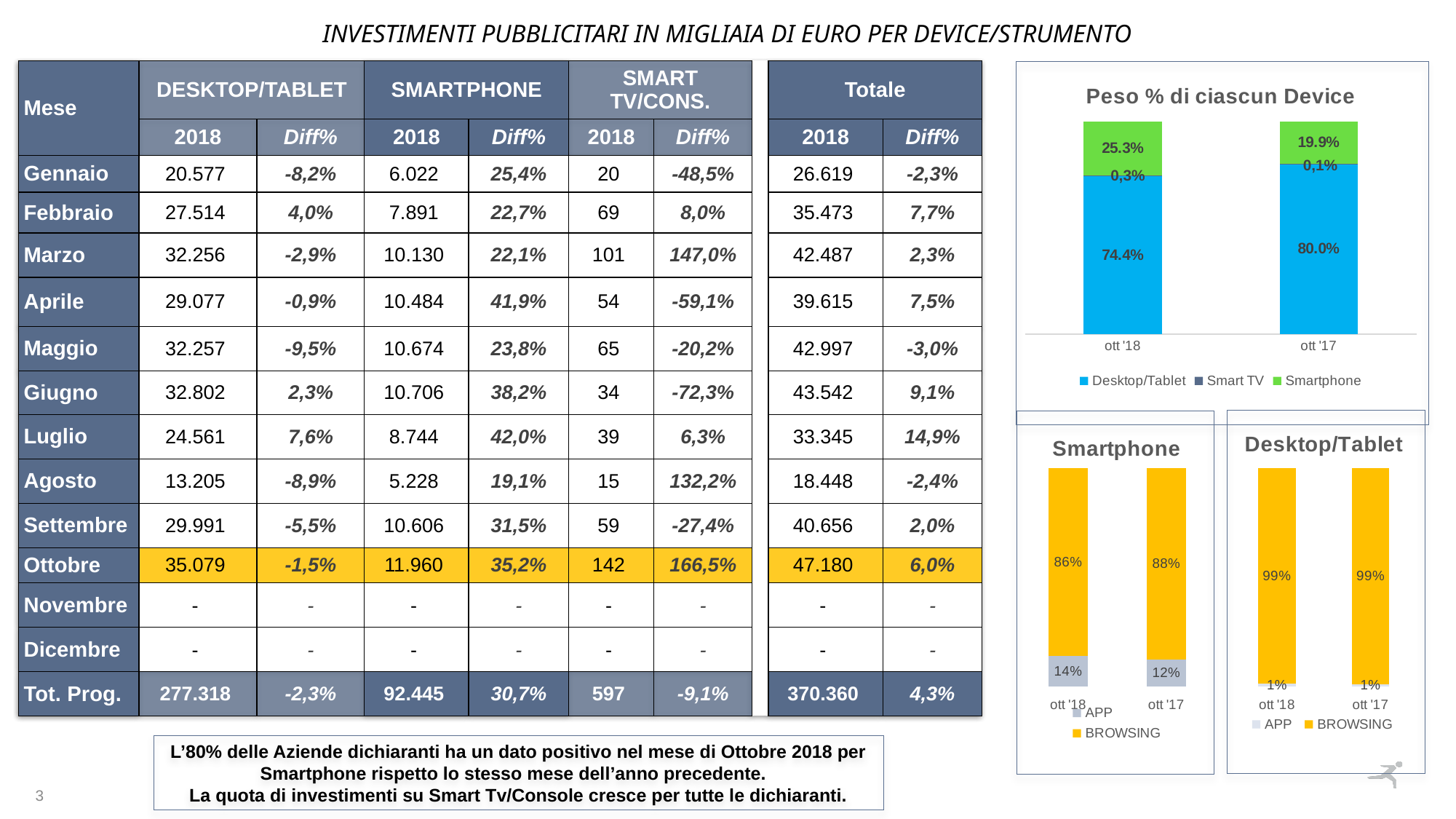
In the 'Peso % di ciascun Device' chart, what is the share for Desktop/Tablet in ott '18? 74.4% How many series does the legend of the 'Peso % di ciascun Device' chart list? 3 In the 'Desktop/Tablet' chart, what is the BROWSING share in ott '18? 99% In the 'Smartphone' chart, what is the APP share in ott '18? 14% What kind of chart is the 'Peso % di ciascun Device' chart? Stacked bar chart In the 'Peso % di ciascun Device' chart, by how many percentage points does the Desktop/Tablet share in ott '17 exceed that in ott '18? 5.6 percentage points In the 'Smartphone' chart, by how many percentage points is the APP share in ott '18 higher than in ott '17? 2 percentage points In the 'Peso % di ciascun Device' chart, which device has the smallest share in ott '18? Smart TV In the 'Smartphone' chart, what is the BROWSING share in ott '17? 88% How many categories are shown on the x axis of the 'Smartphone' chart? 2 In the 'Peso % di ciascun Device' chart, what is the share for Smartphone in ott '17? 19.9% In the 'Peso % di ciascun Device' chart, is the Smartphone share larger in ott '18 or in ott '17? ott '18